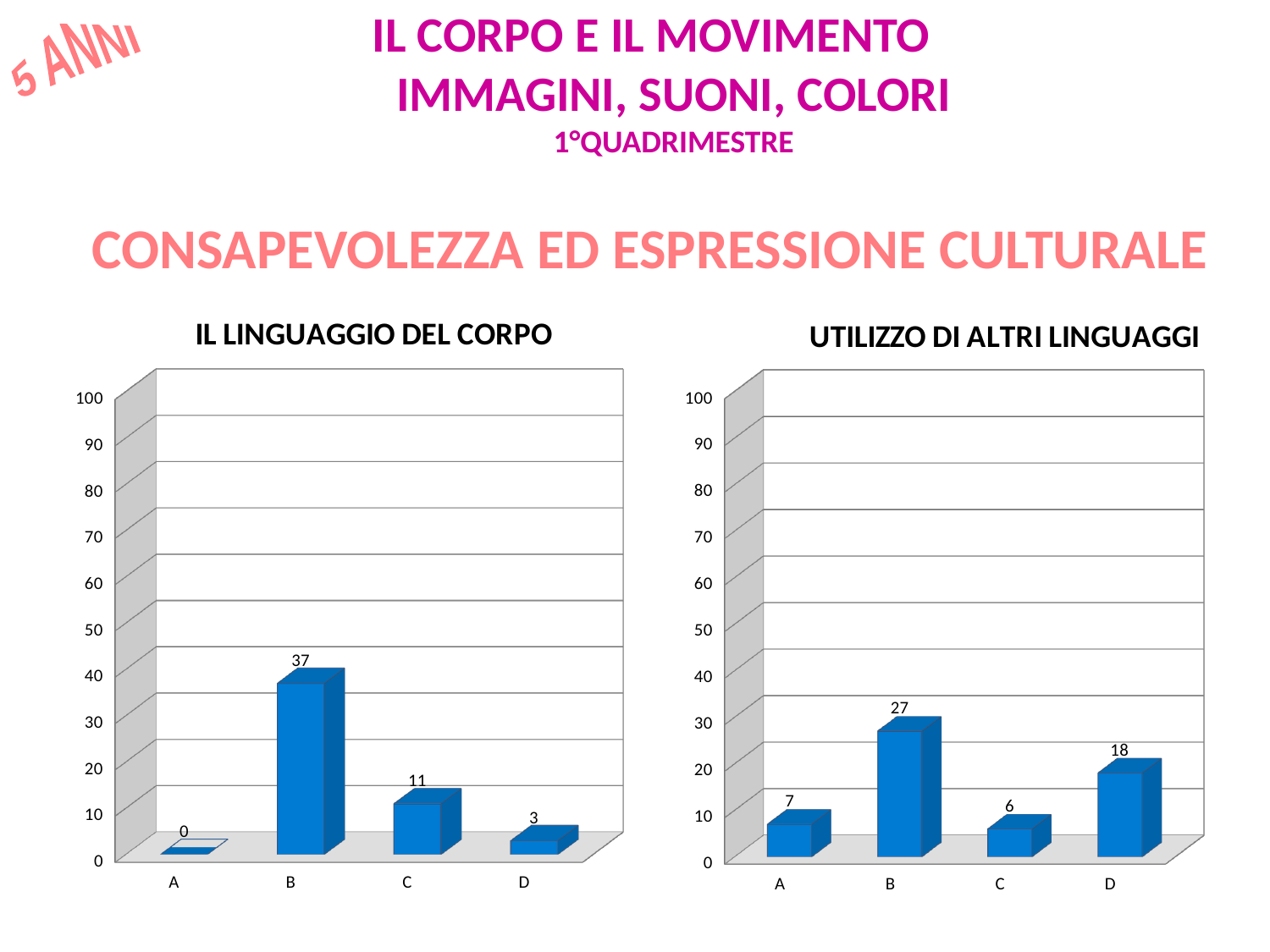
In the 'IL LINGUAGGIO DEL CORPO' chart, is the value for B greater or less than 30? greater In the 'IL LINGUAGGIO DEL CORPO' chart, what is the difference between the values for B and C? 26 In the 'IL LINGUAGGIO DEL CORPO' chart, what is the value for category B? 37 What kind of chart is 'IL LINGUAGGIO DEL CORPO'? bar chart In the 'UTILIZZO DI ALTRI LINGUAGGI' chart, which is larger, the value for A or the value for D? D In the 'UTILIZZO DI ALTRI LINGUAGGI' chart, what is the value for category C? 6 In the 'UTILIZZO DI ALTRI LINGUAGGI' chart, what is the value for category D? 18 In the 'UTILIZZO DI ALTRI LINGUAGGI' chart, which category has the lowest value? C In the 'IL LINGUAGGIO DEL CORPO' chart, what is the value for category A? 0 In the 'UTILIZZO DI ALTRI LINGUAGGI' chart, what is the difference between the values for B and D? 9 How many categories are shown in the 'UTILIZZO DI ALTRI LINGUAGGI' chart? 4 In the 'IL LINGUAGGIO DEL CORPO' chart, which category has the highest value? B